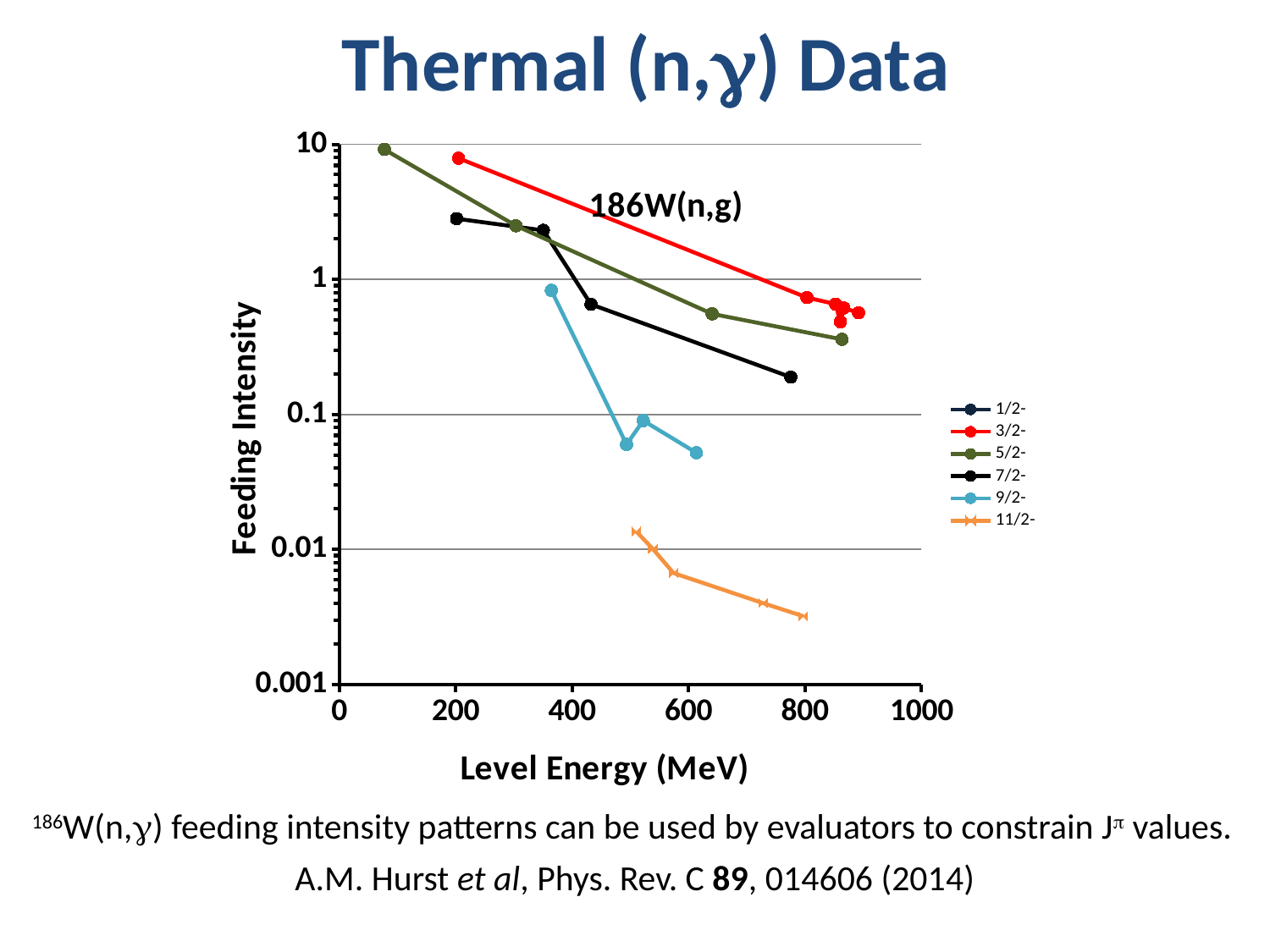
What is the label of the y axis? Feeding Intensity Is the feeding intensity of the last (highest-energy) point of the 7/2- series greater or less than 1? less At a level energy of about 800 MeV, which series has the higher feeding intensity, 3/2- or 7/2-? 3/2- How many series does the legend list? 6 How many data points are plotted for the 7/2- series? 4 Which series has the lowest feeding intensity values on the chart? 11/2- What is the label of the x axis? Level Energy (MeV) Is the feeding intensity of the first (lowest-energy) point of the 3/2- series greater or less than 1? greater Does the feeding intensity for the 3/2- series rise or fall as level energy increases? fall Does the feeding intensity for the 11/2- series rise or fall as level energy increases? fall Are the feeding intensity values for the 11/2- series greater or less than 0.1? less What kind of chart is shown on the slide? line chart